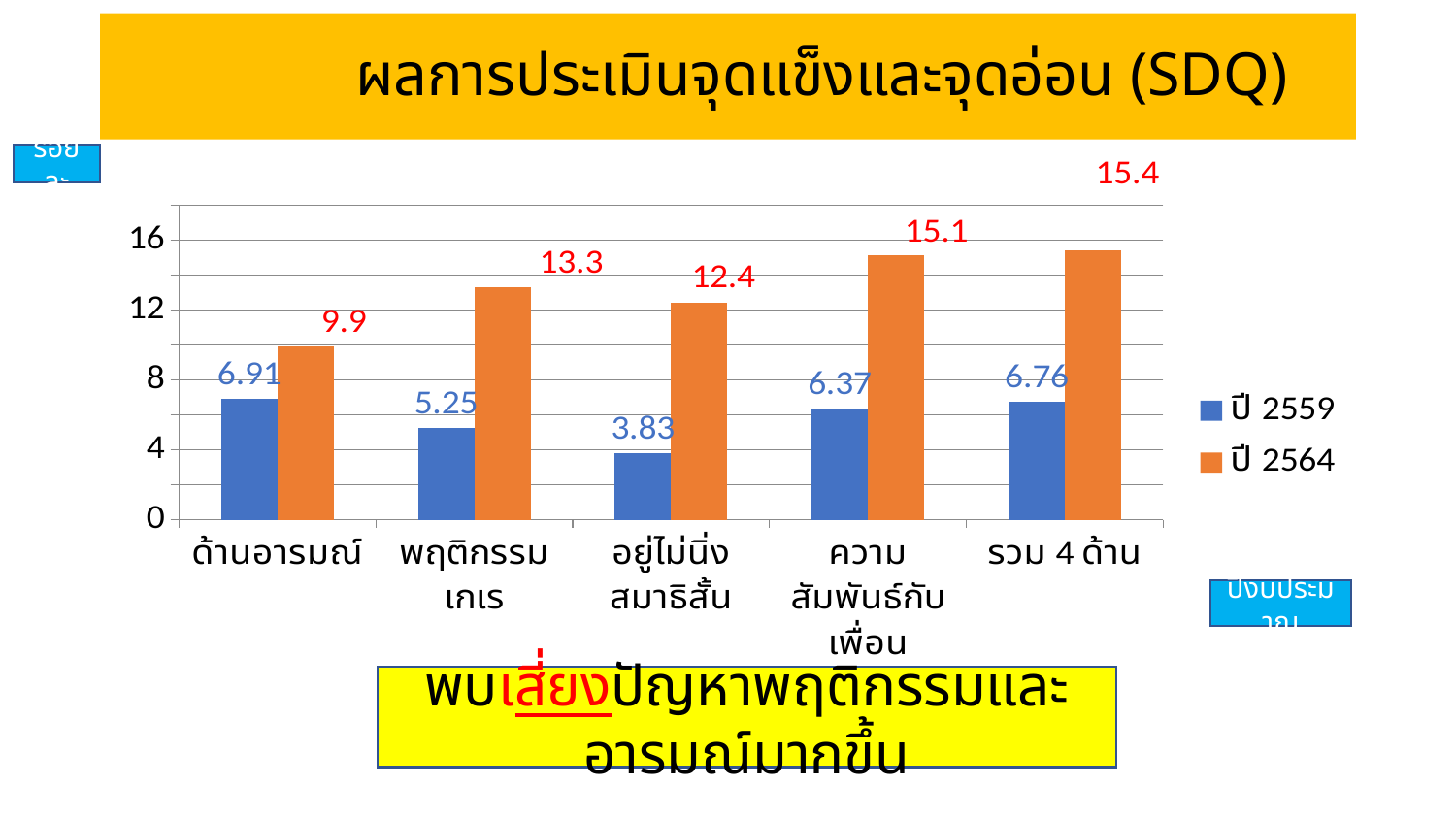
Which category has the highest value in the ปี 2564 series? รวม 4 ด้าน How many series does the legend list? 2 What is the difference between the ปี 2564 and ปี 2559 values for ความสัมพันธ์กับเพื่อน? 8.73 How many categories are shown on the x axis? 5 What is the title of the chart on the slide? ผลการประเมินจุดแข็งและจุดอ่อน (SDQ) Is the ปี 2564 value for อยู่ไม่นิ่งสมาธิสั้น greater or less than 12? greater Which category has the lowest value in the ปี 2559 series? อยู่ไม่นิ่งสมาธิสั้น What kind of chart is shown on the slide? bar chart What is the value for พฤติกรรมเกเร in the ปี 2564 series? 13.3 What is the value for อยู่ไม่นิ่งสมาธิสั้น in the ปี 2559 series? 3.83 Which is larger for ด้านอารมณ์: the ปี 2559 value or the ปี 2564 value? ปี 2564 What is the value for ด้านอารมณ์ in the ปี 2559 series? 6.91